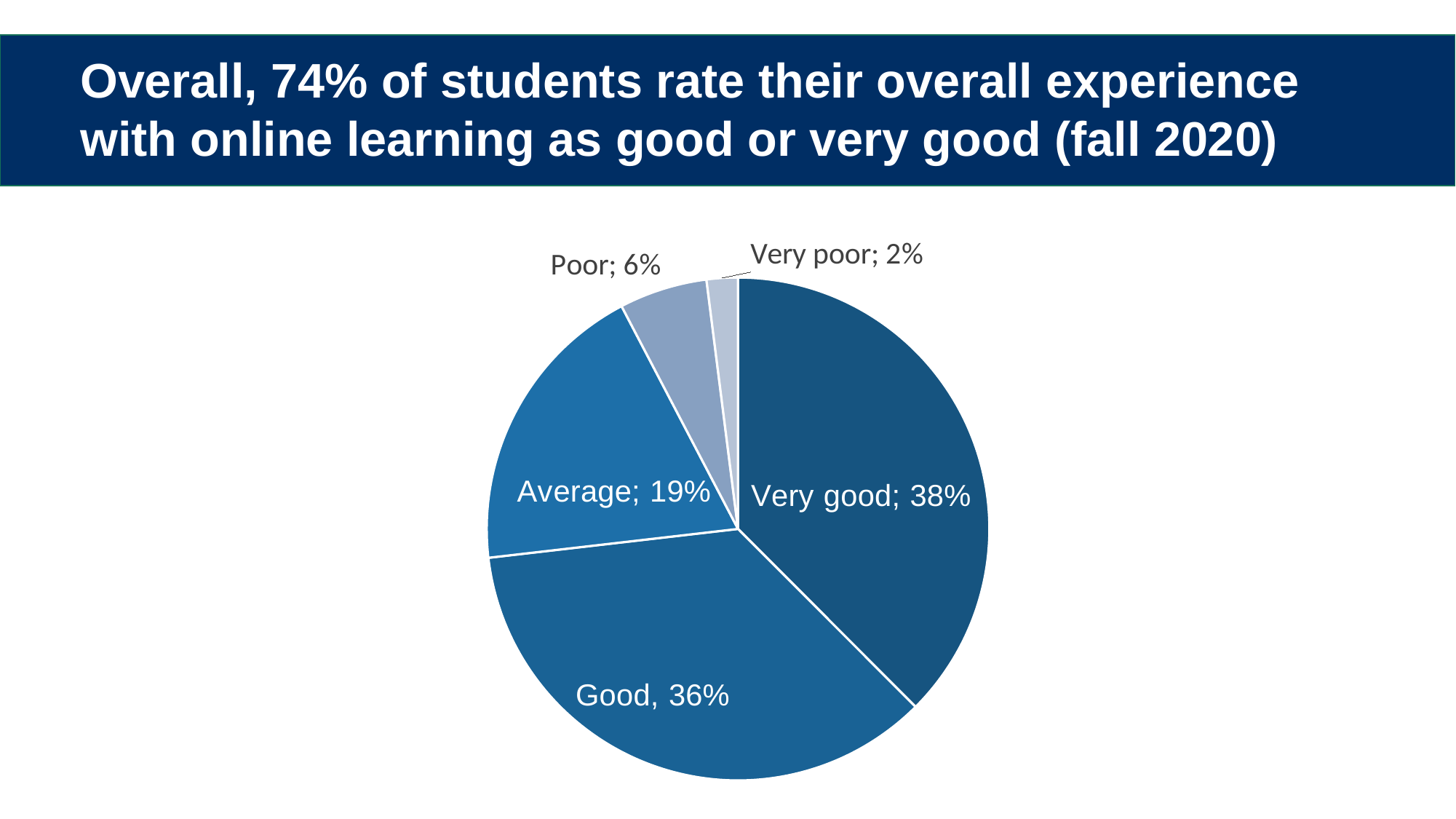
What percentage of students rated their online learning experience as Good? 36% What percentage of students rated their online learning experience as Very poor? 2% What percentage of students rated their online learning experience as Average? 19% What is the combined share of the Very good and Good slices? 74% What is the difference in percentage points between the Average and Poor slices? 13 What kind of chart is shown on the slide? pie chart How many slices does the pie chart have? 5 Which is larger, the Good slice or the Average slice? Good What percentage of students rated their online learning experience as Very good? 38% Which rating category has the largest share of the pie? Very good What percentage of students rated their online learning experience as Poor? 6% Which rating category has the smallest share of the pie? Very poor